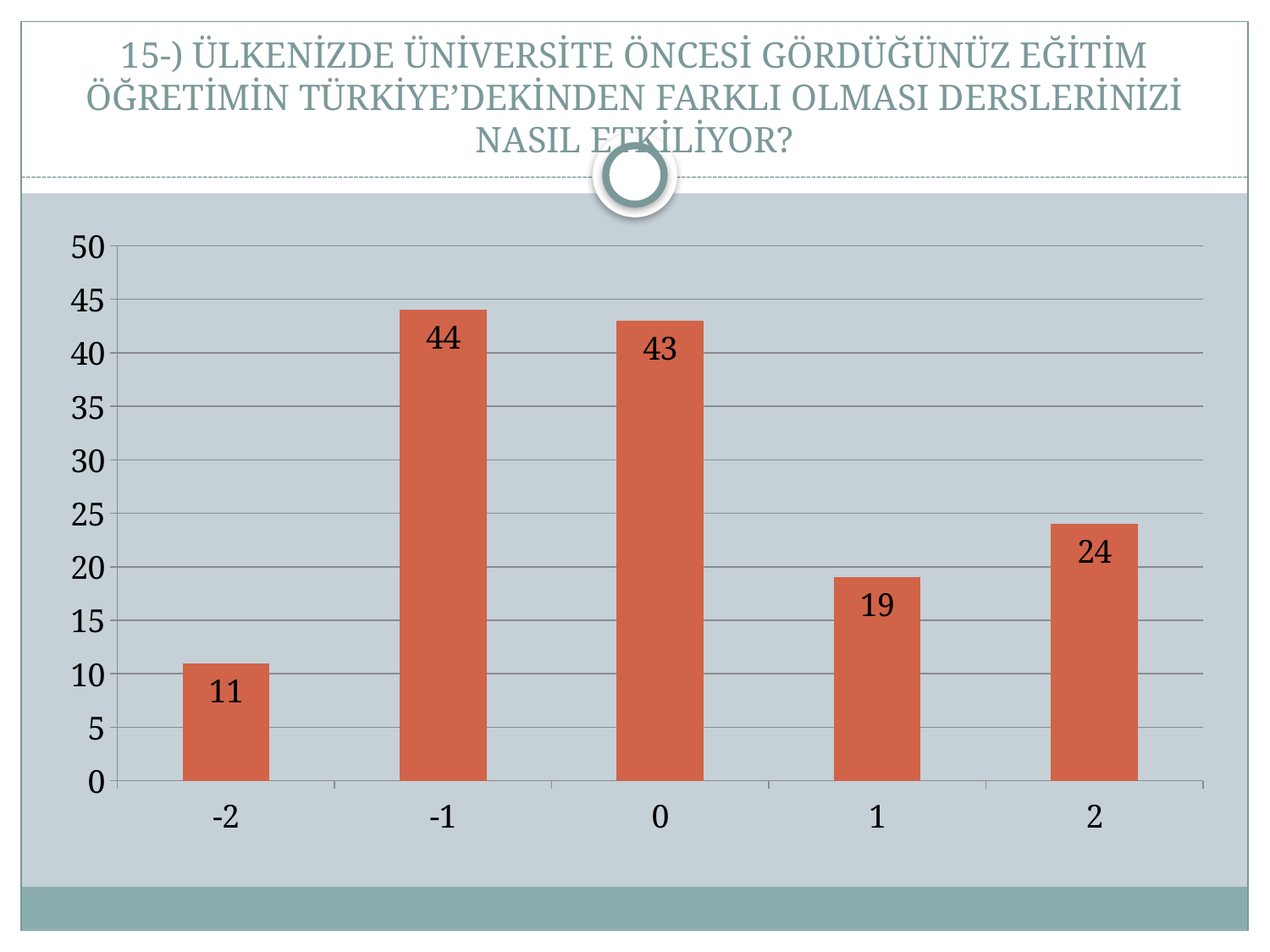
What is the difference between the values for -1 and -2? 33 Which is larger, the value for 1 or the value for 2? 2 Is the value for 0 greater or less than 40? greater What is the value for category 2? 24 What kind of chart is shown on the slide? bar chart What is the difference between the values for 0 and 1? 24 What is the value for category -2? 11 What is the value for category -1? 44 What is the maximum value shown on the y axis? 50 Which category has the lowest value? -2 Which category has the highest value? -1 How many categories are shown on the x axis? 5